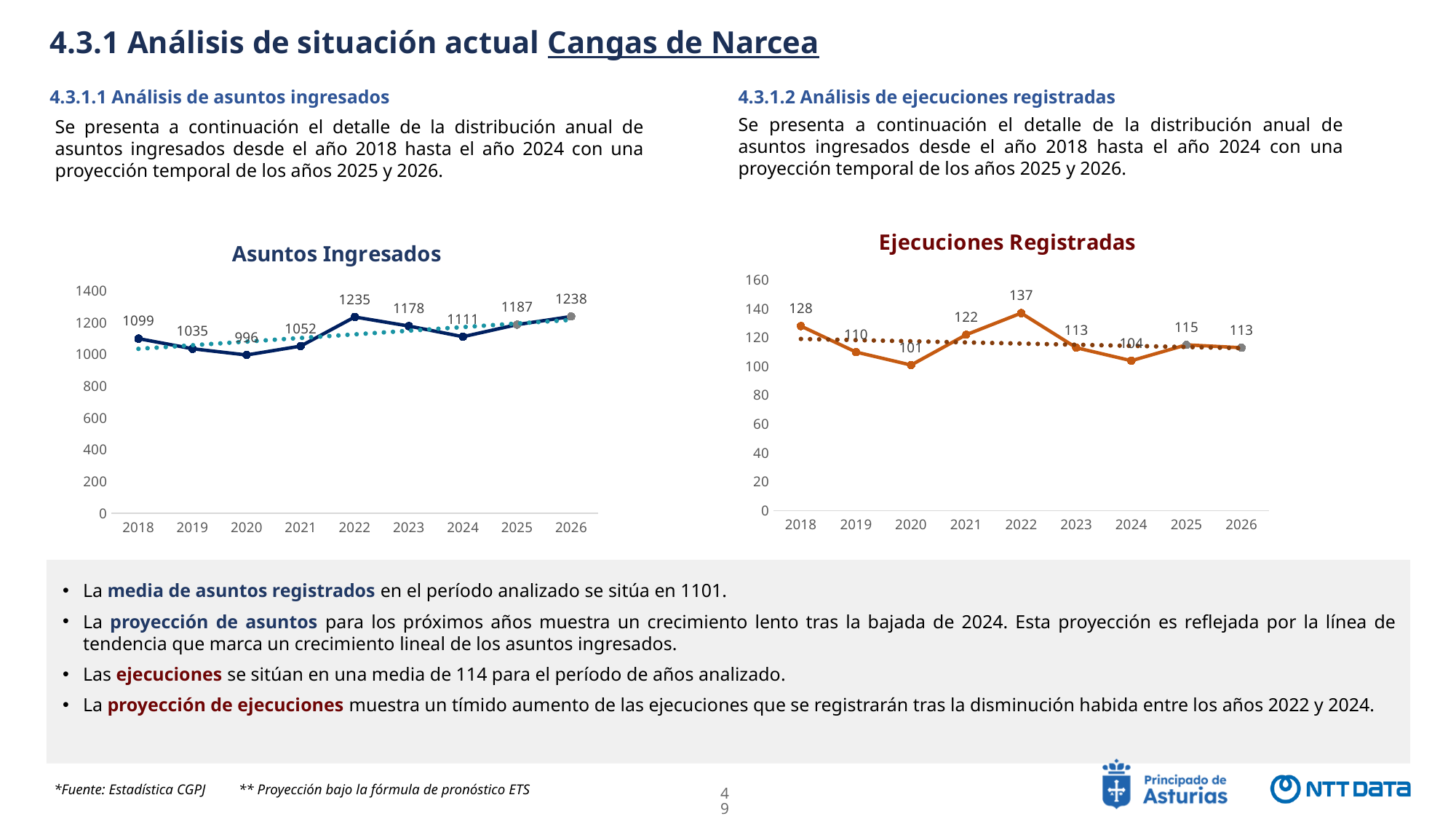
In the 'Ejecuciones Registradas' chart, which year has the highest value? 2022 In the 'Ejecuciones Registradas' chart, which is larger, the value for 2018 or the value for 2021? 2018 In the 'Ejecuciones Registradas' chart, what is the value for 2024? 104 In the 'Asuntos Ingresados' chart, which year has the highest value? 2026 In the 'Asuntos Ingresados' chart, which year has the lowest value? 2020 In the 'Asuntos Ingresados' chart, how many years are plotted on the x axis? 9 What kind of chart is the 'Ejecuciones Registradas' chart? line chart In the 'Asuntos Ingresados' chart, is the value for 2019 greater or less than 1200? less In the 'Ejecuciones Registradas' chart, which year has the lowest value? 2020 In the 'Asuntos Ingresados' chart, what is the difference between the values for 2022 and 2021? 183 In the 'Asuntos Ingresados' chart, what is the value for 2022? 1235 In the 'Ejecuciones Registradas' chart, what is the difference between the values for 2022 and 2023? 24